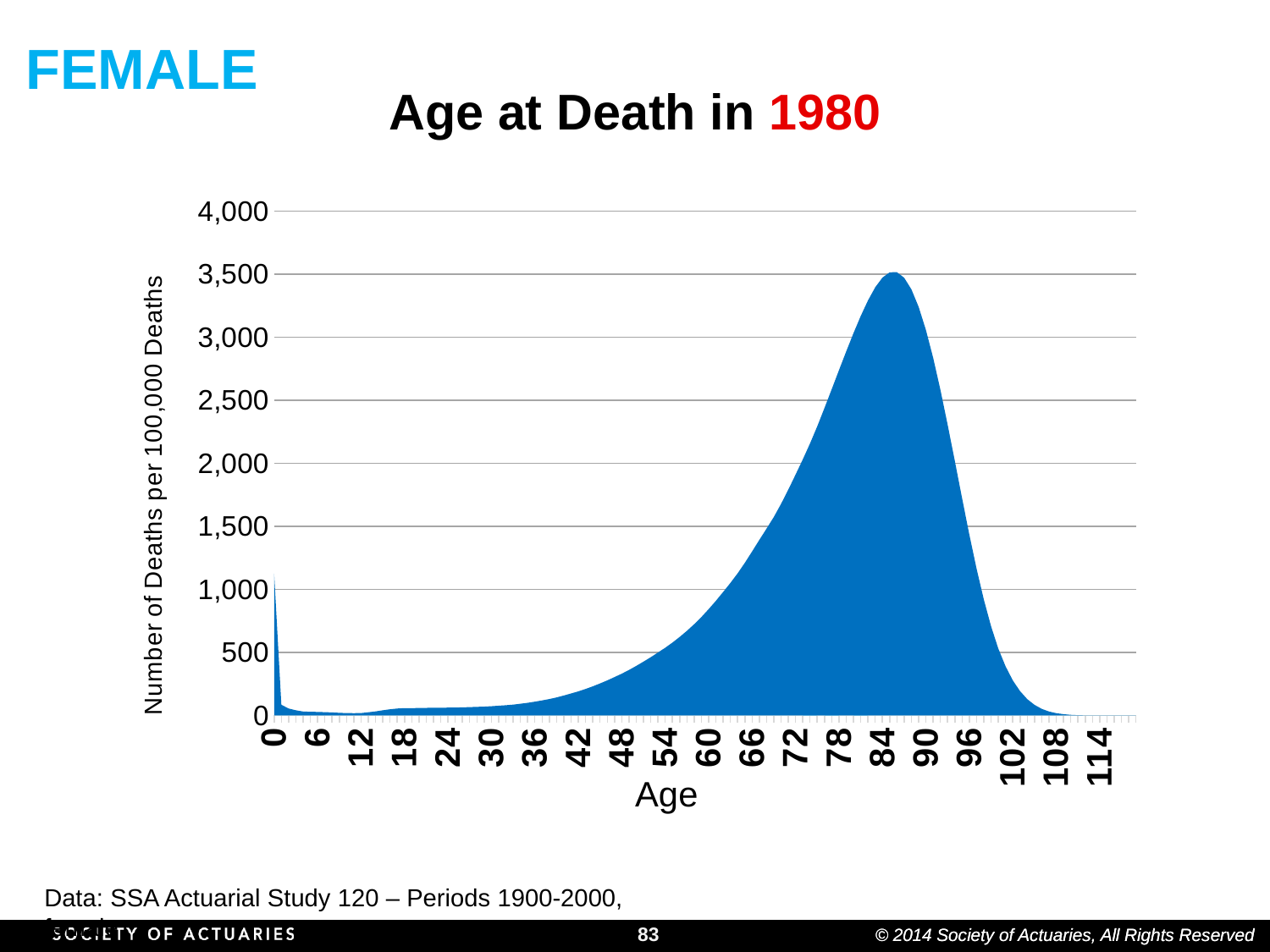
Is the value at age 30 greater or less than 500? less Between ages 90 and 108, do the values rise or fall as age increases? fall Is the value at age 72 greater or less than 500? greater What kind of chart is shown on the slide? Area chart Is the value at age 0 greater or less than 500? greater What is the highest value shown on the vertical axis? 4,000 What is the title of the chart? Age at Death in 1980 Between ages 30 and 84, do the values rise or fall as age increases? rise What is the label of the vertical axis? Number of Deaths per 100,000 Deaths